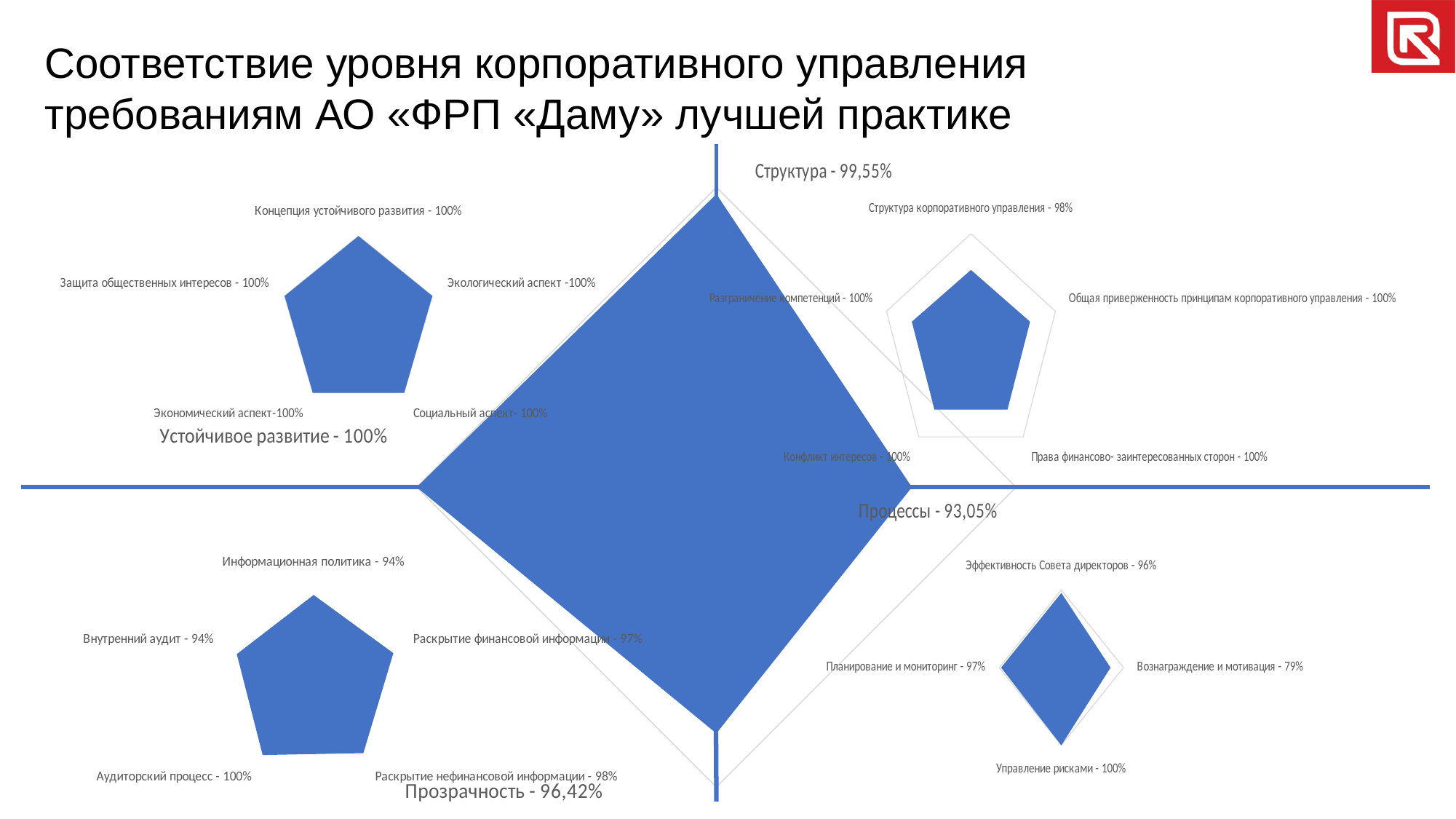
In the Структура chart (top right), which is larger: Структура корпоративного управления or Конфликт интересов? Конфликт интересов What is the overall value shown for Процессы on the central chart? 93,05% What is the overall value shown for Структура on the central chart? 99,55% In the Процессы chart (bottom right), which category has the lowest value? Вознаграждение и мотивация What kind of chart is the large central chart? Radar chart On the central chart, which of the four areas has the lowest overall value? Процессы In the Прозрачность chart (bottom left), what is the value for Раскрытие нефинансовой информации? 98% What is the overall value shown for Прозрачность on the central chart? 96,42% How many categories does the Устойчивое развитие chart (top left) have? 5 In the Прозрачность chart (bottom left), what is the difference between Аудиторский процесс and Внутренний аудит? 6% In the Процессы chart (bottom right), what is the value for Вознаграждение и мотивация? 79% On the central chart, which of the four areas has the highest overall value? Устойчивое развитие